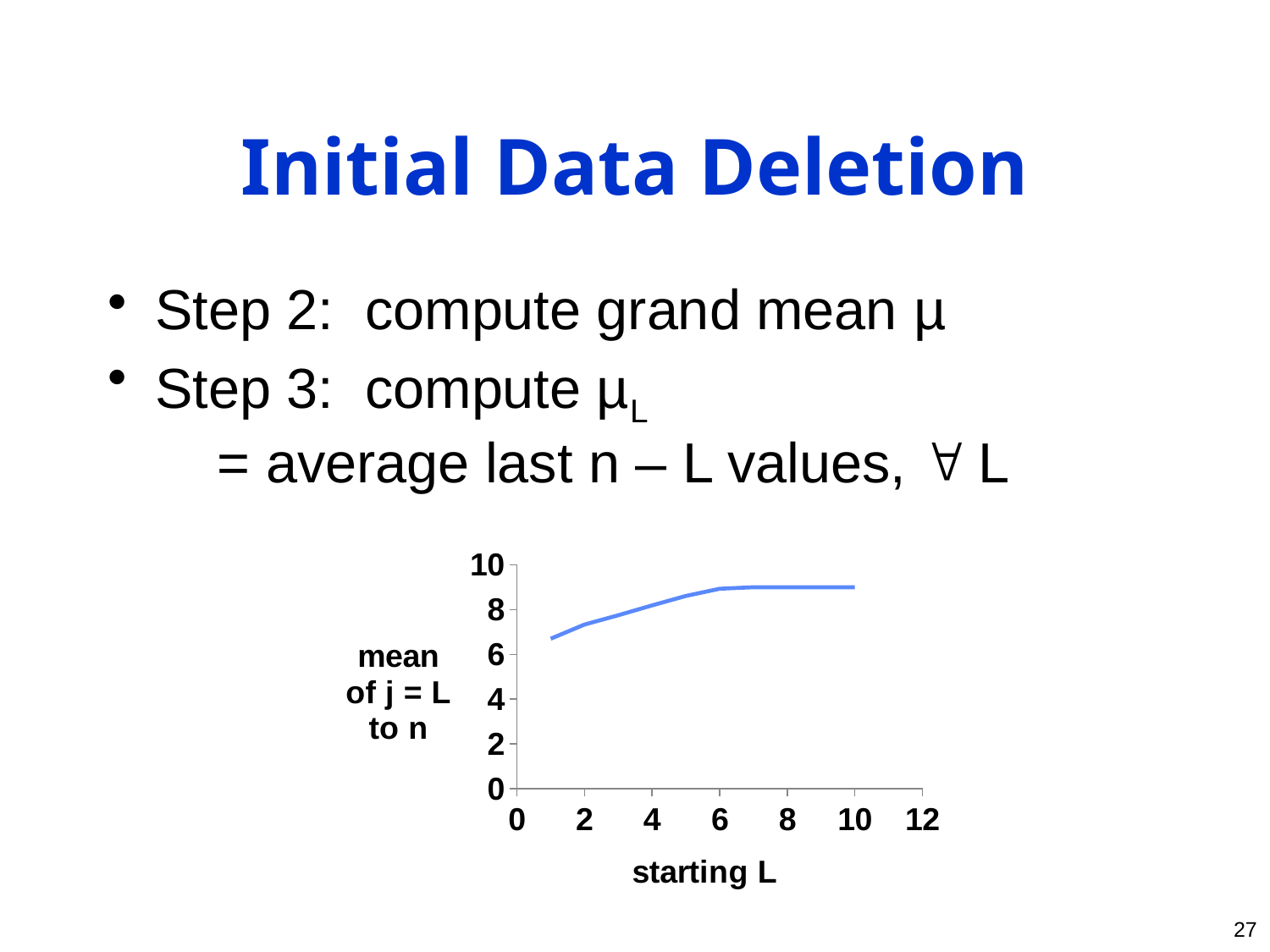
What is the highest tick value shown on the y axis? 10 What is the highest tick value shown on the x axis? 12 What is the label of the y axis? mean of j = L to n Is the value of the line at starting L = 10 greater or less than 8? greater How many lines are plotted on the chart? 1 Does the plotted line rise or fall as starting L increases from 1 to 6? rise What kind of chart is shown on the slide? line chart What is the label of the x axis? starting L Is the value of the line at starting L = 2 greater or less than 6? greater Is the value of the line at starting L = 8 greater or less than 10? less Which is larger: the value of the line at starting L = 1 or at starting L = 6? starting L = 6